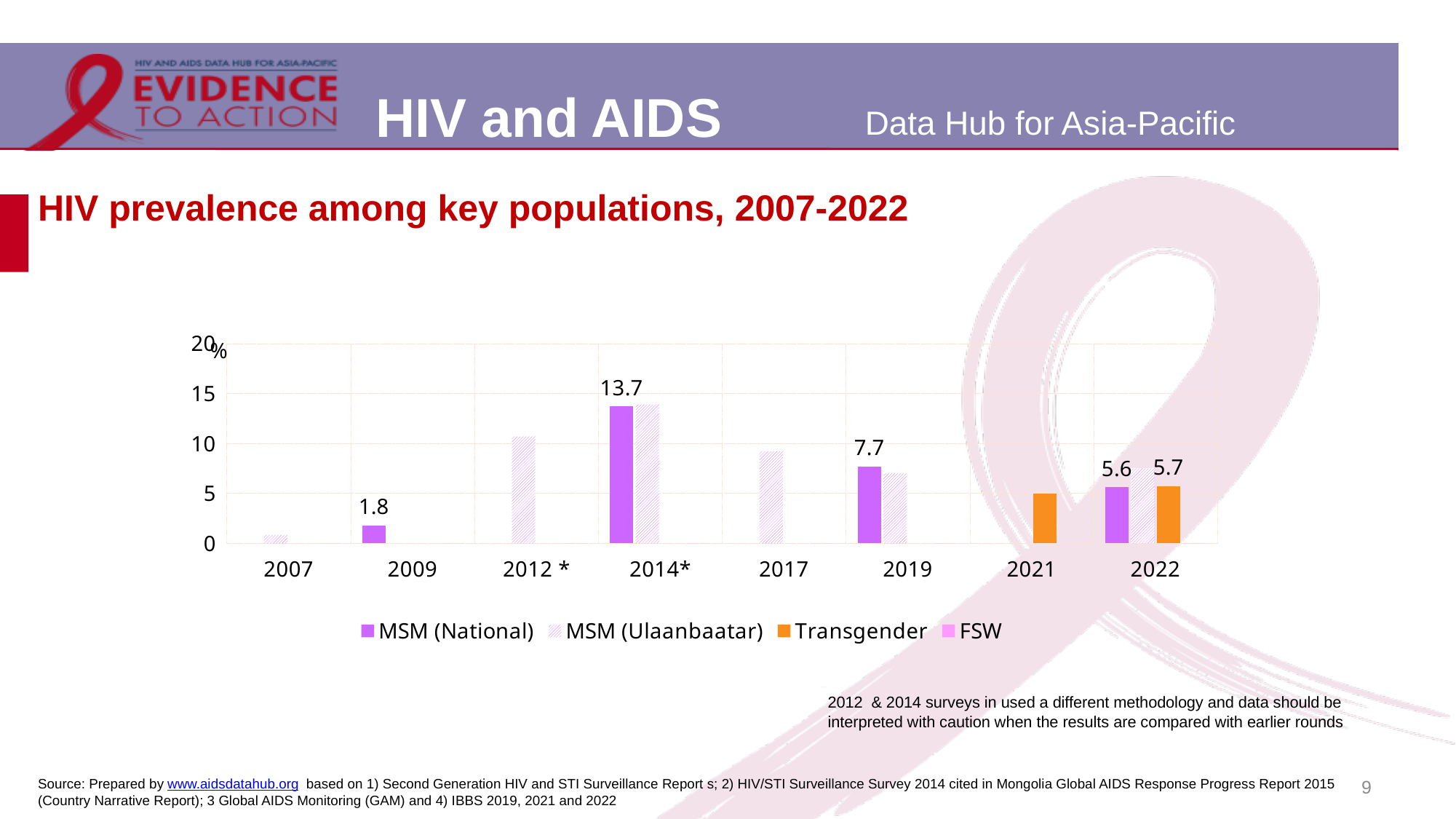
What is the difference between the MSM (National) HIV prevalence in 2014* and in 2019? 6 What is the HIV prevalence among Transgender people in 2022? 5.7 What is the HIV prevalence among MSM (National) in 2009? 1.8 In which year is the MSM (National) HIV prevalence highest? 2014* How many years are shown on the x axis of the chart? 8 What kind of chart is shown on the slide? bar chart What is the HIV prevalence among MSM (National) in 2014*? 13.7 Is the value for MSM (Ulaanbaatar) in 2017 greater or less than 5? greater Does the MSM (National) HIV prevalence rise or fall from 2014* to 2022? fall In 2022, which is higher: the HIV prevalence among MSM (National) or among Transgender people? Transgender What is the HIV prevalence among MSM (National) in 2022? 5.6 How many series does the chart legend list? 4